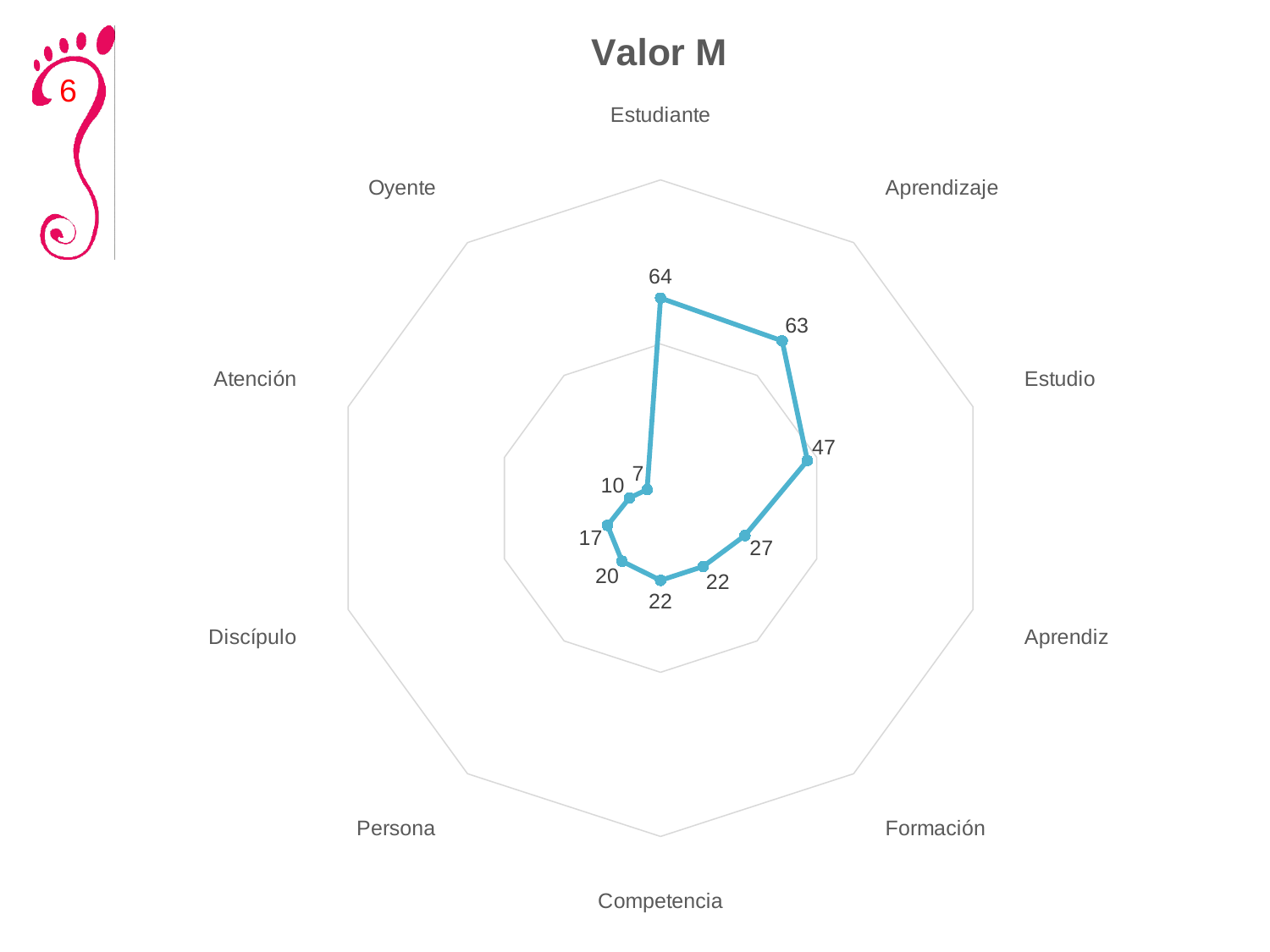
What is the value for Estudiante? 64 How many categories does the radar chart have? 10 Which category has the highest value? Estudiante What is the value for Estudio? 47 What is the difference between the values for Estudiante and Estudio? 17 What is the value for Oyente? 7 What is the value for Aprendizaje? 63 Which is larger, the value for Aprendiz or the value for Persona? Aprendiz What is the value for Discípulo? 17 What type of chart is shown on the slide? Radar chart Which category has the lowest value? Oyente What is the title of the chart? Valor M